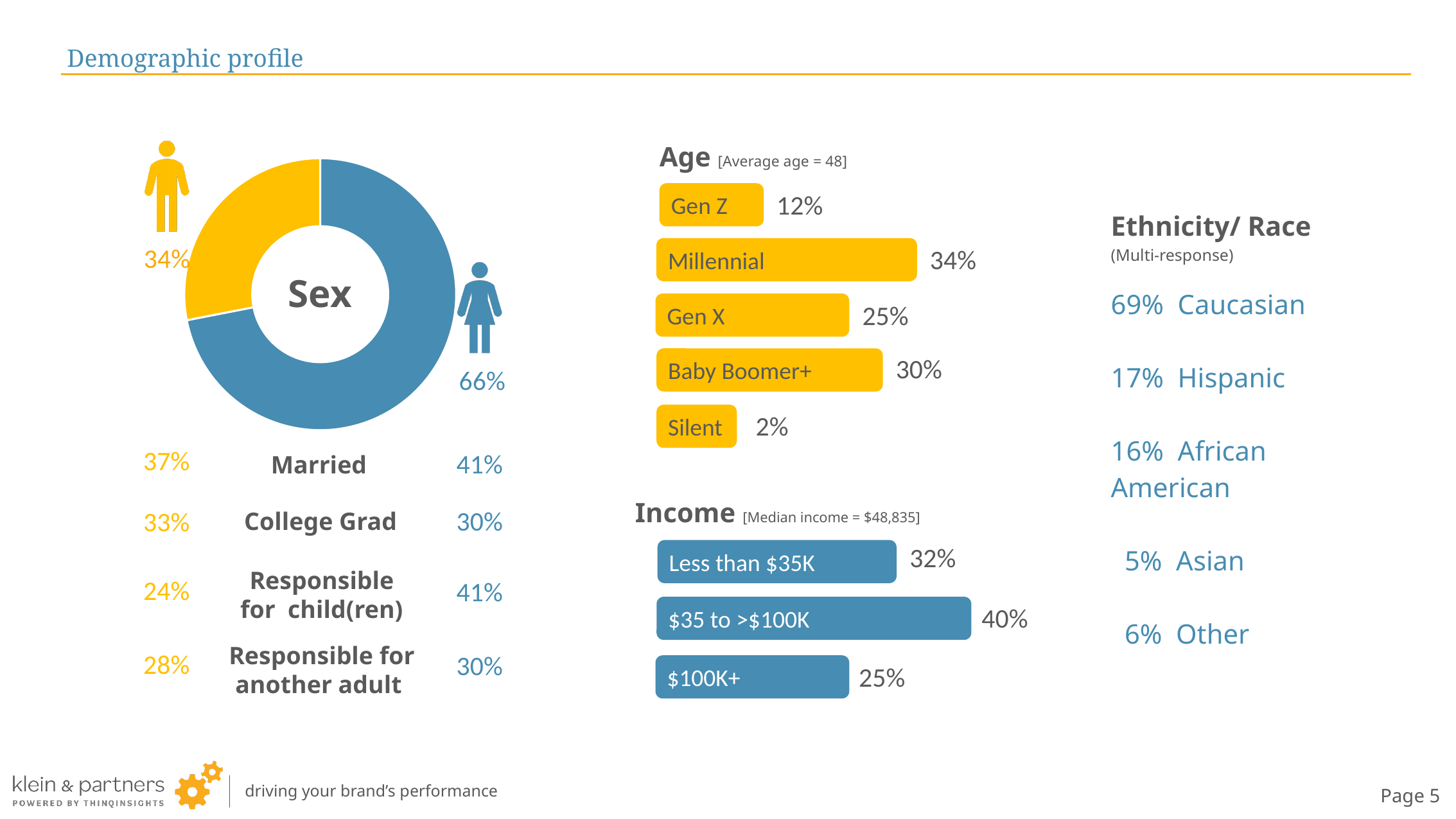
What median income is stated in the Income chart title? $48,835 In the Sex donut chart, what share is shown for the yellow (male) segment? 34% In the Age bar chart, which category has the lowest value? Silent In the Income bar chart, which category has the highest value? $35 to >$100K What kind of chart is the Sex chart? Donut (pie) chart In the Age bar chart, which category has the highest value? Millennial In the Age bar chart, what is the difference between Baby Boomer+ and Gen X? 5% In the Income bar chart, is the value for Less than $35K larger or smaller than the value for $100K+? Larger In the Sex donut chart, what share is shown for the blue (female) segment? 66% In the Income bar chart, what is the value for $100K+? 25% How many categories are shown in the Age bar chart? 5 In the Age bar chart, what is the value for Millennial? 34%